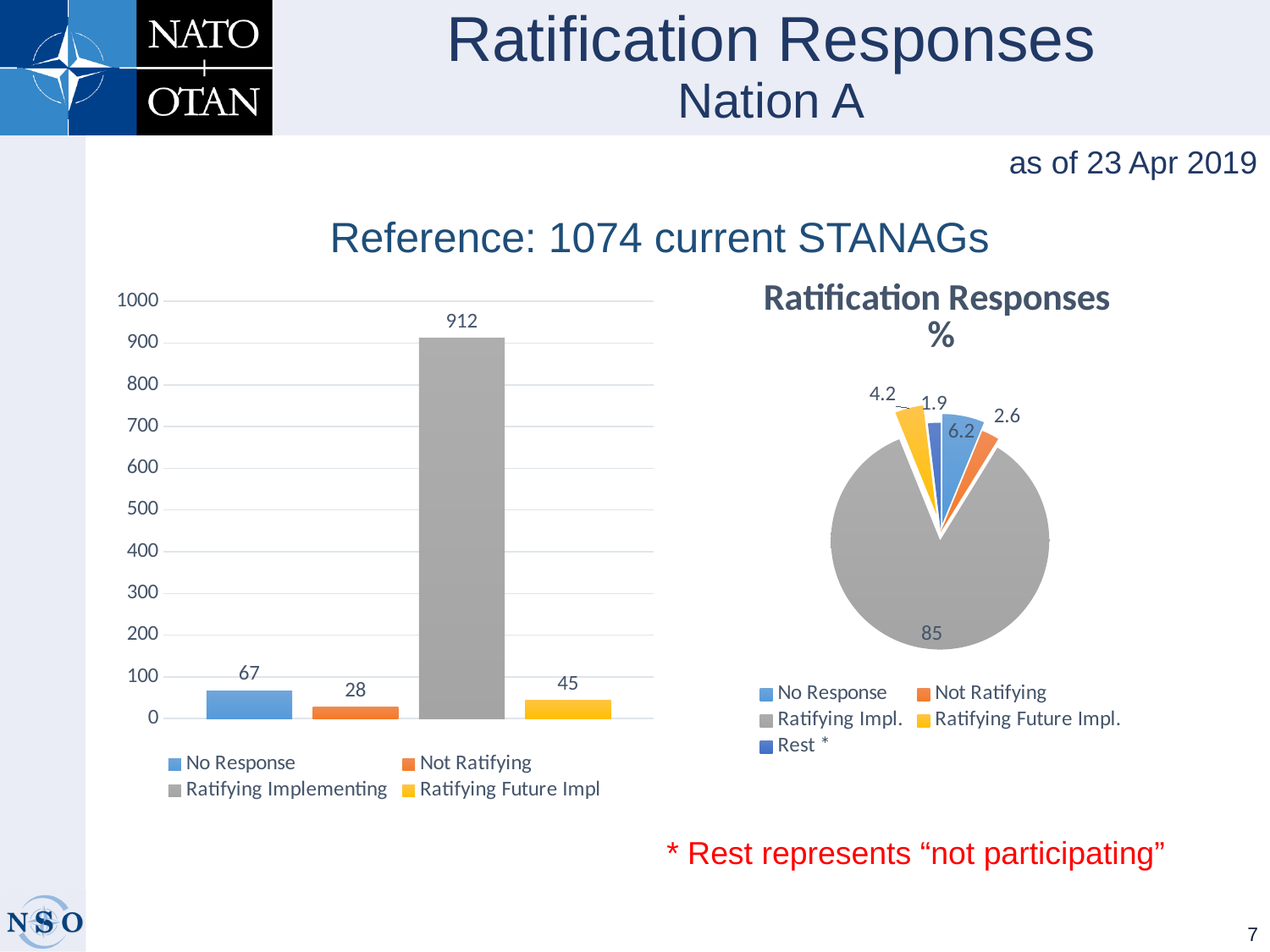
In the bar chart on the left, what is the difference between the No Response and Ratifying Future Impl values? 22 In the 'Ratification Responses %' pie chart, what value is shown for Rest *? 1.9 In the bar chart on the left, which is larger: No Response or Not Ratifying? No Response In the bar chart on the left, what is the value for Not Ratifying? 28 What kind of chart is the chart on the left of the slide? Bar chart In the bar chart on the left, what is the value for Ratifying Implementing? 912 In the 'Ratification Responses %' pie chart, how many entries does the legend list? 5 In the bar chart on the left, which category has the highest value? Ratifying Implementing In the bar chart on the left, what is the value for No Response? 67 In the bar chart on the left, how many series does the legend list? 4 In the 'Ratification Responses %' pie chart, what percentage is shown for Ratifying Impl.? 85 In the bar chart on the left, which category has the lowest value? Not Ratifying